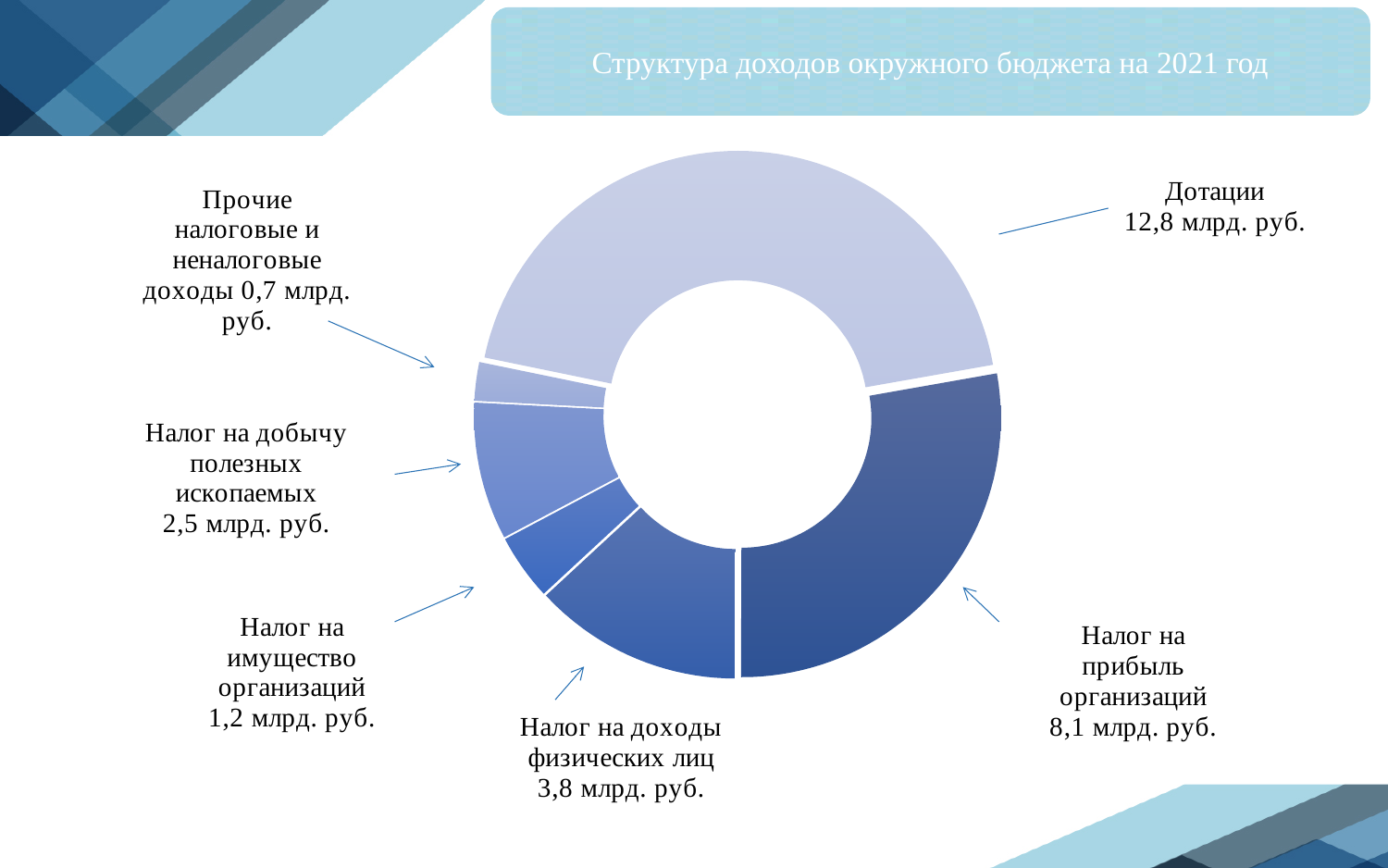
What is the value shown for Налог на добычу полезных ископаемых? 2,5 млрд. руб. What is the value shown for Дотации? 12,8 млрд. руб. How many categories are shown in the chart? 6 Which category has the smallest value in the chart? Прочие налоговые и неналоговые доходы What kind of chart is shown on the slide? doughnut chart What is the difference between Дотации and Налог на прибыль организаций? 4,7 млрд. руб. Which is larger: Налог на добычу полезных ископаемых or Налог на имущество организаций? Налог на добычу полезных ископаемых What is the value shown for Налог на прибыль организаций? 8,1 млрд. руб. What is the value shown for Прочие налоговые и неналоговые доходы? 0,7 млрд. руб. Which category has the largest value in the chart? Дотации What is the title of the slide? Структура доходов окружного бюджета на 2021 год What is the value shown for Налог на доходы физических лиц? 3,8 млрд. руб.